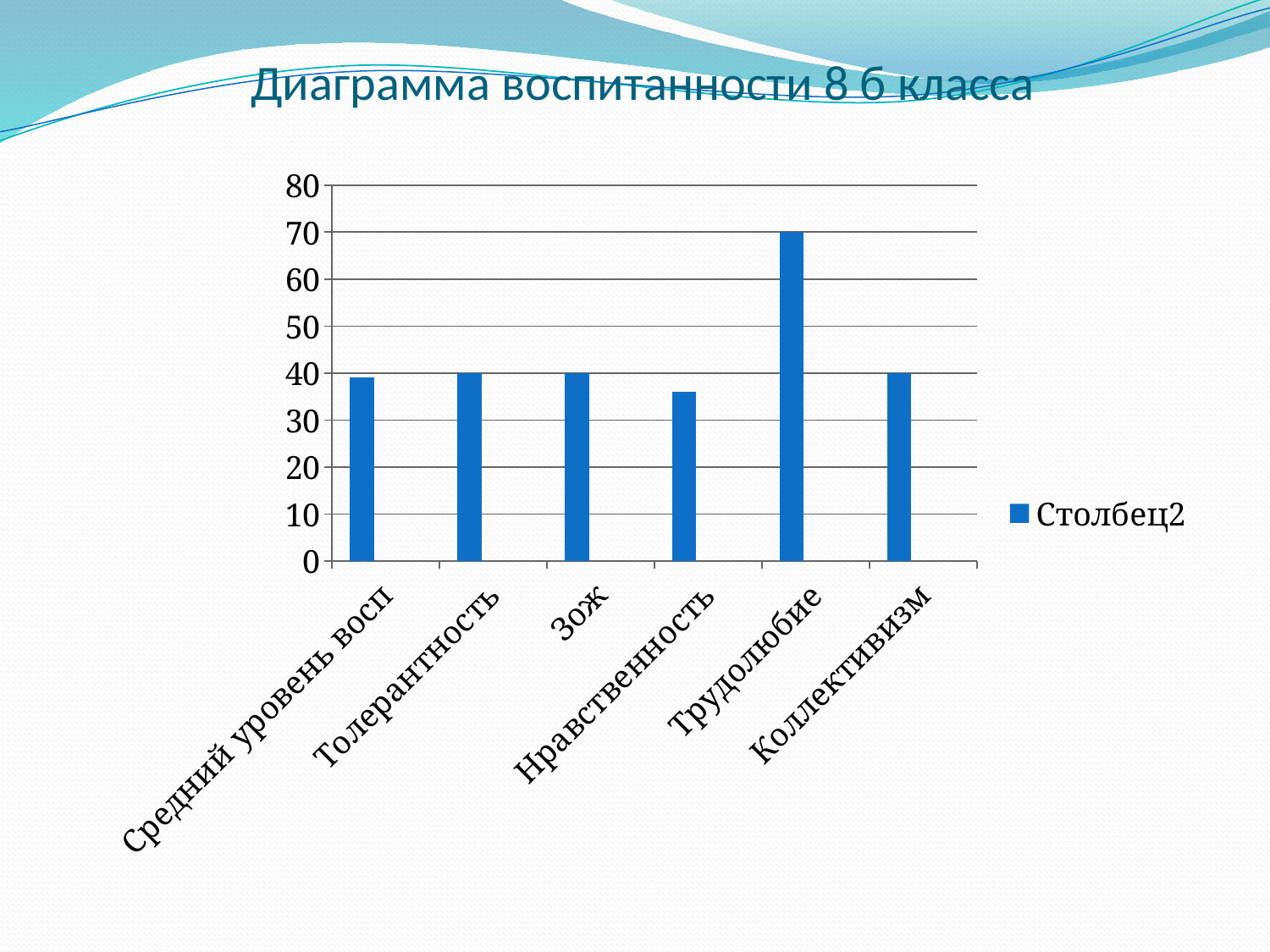
What is the difference between the values for Трудолюбие and Коллективизм? 30 How many series does the chart legend list? 1 How many categories are shown on the x axis of the chart? 6 Which is larger, the value for Трудолюбие or the value for Зож? Трудолюбие What is the value for Трудолюбие? 70 Which category has the lowest value? Нравственность What type of chart is shown on the slide? Bar chart What is the title of the chart on the slide? Диаграмма воспитанности 8 б класса Which category has the highest value? Трудолюбие Is the value for Нравственность greater or less than 40? less What is the value for Коллективизм? 40 What is the value for Толерантность? 40